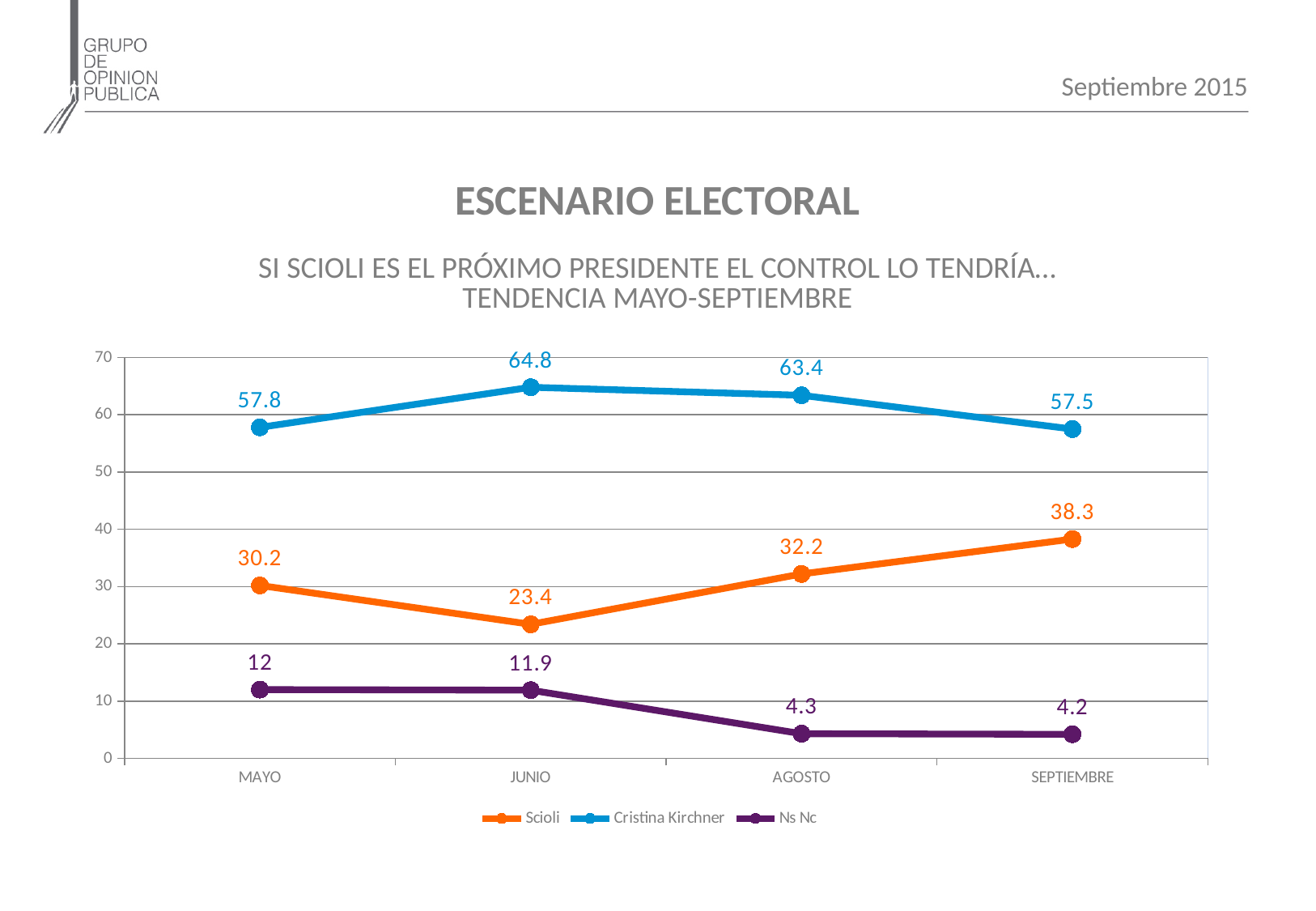
What is the value for Ns Nc in AGOSTO? 4.3 Is the value for Scioli in AGOSTO greater or less than 30? greater In which month is the Scioli series lowest? JUNIO What kind of chart is shown on the slide? line chart How many series does the legend list? 3 How many months are shown on the x axis? 4 What is the value for Scioli in SEPTIEMBRE? 38.3 What is the value for Cristina Kirchner in JUNIO? 64.8 Which is larger in MAYO: the value for Scioli or the value for Ns Nc? Scioli What is the difference between Cristina Kirchner and Scioli in SEPTIEMBRE? 19.2 In which month is the Cristina Kirchner series highest? JUNIO Does the Ns Nc series rise or fall from MAYO to SEPTIEMBRE? fall